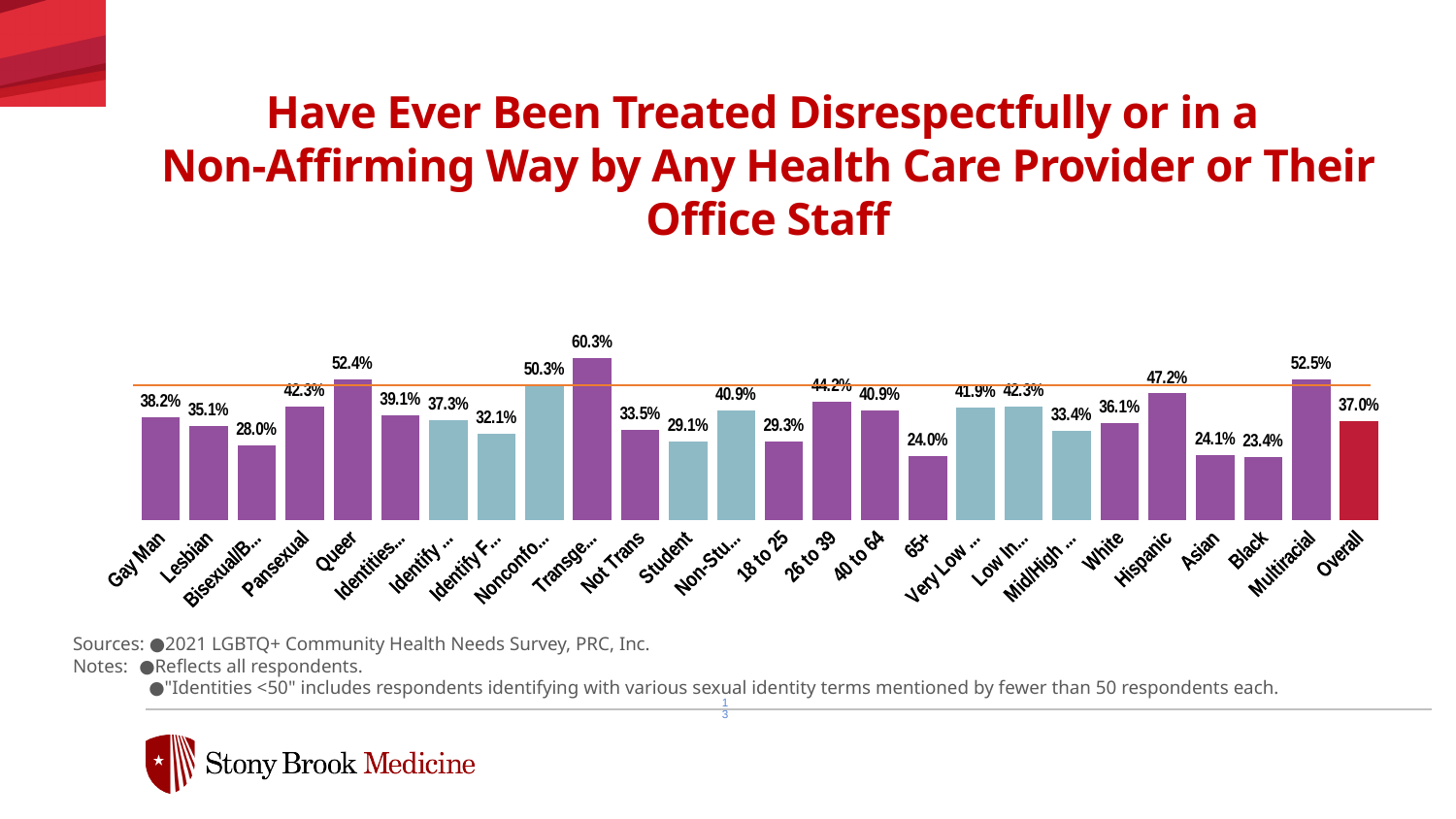
What is the highest value shown on the chart? 60.3% What is the value for Gay Man? 38.2% What is the difference between the values for Queer and Lesbian? 17.3 percentage points What is the value for 65+? 24.0% Which is larger, the value for 26 to 39 or the value for 40 to 64? 26 to 39 What kind of chart is shown on the slide? Bar chart What is the value for Overall? 37.0% Which category has the lowest value? Black How many bars are shown on the chart? 26 What is the difference between the values for Multiracial and Black? 29.1 percentage points What is the value for Hispanic? 47.2% What is the value for Queer? 52.4%